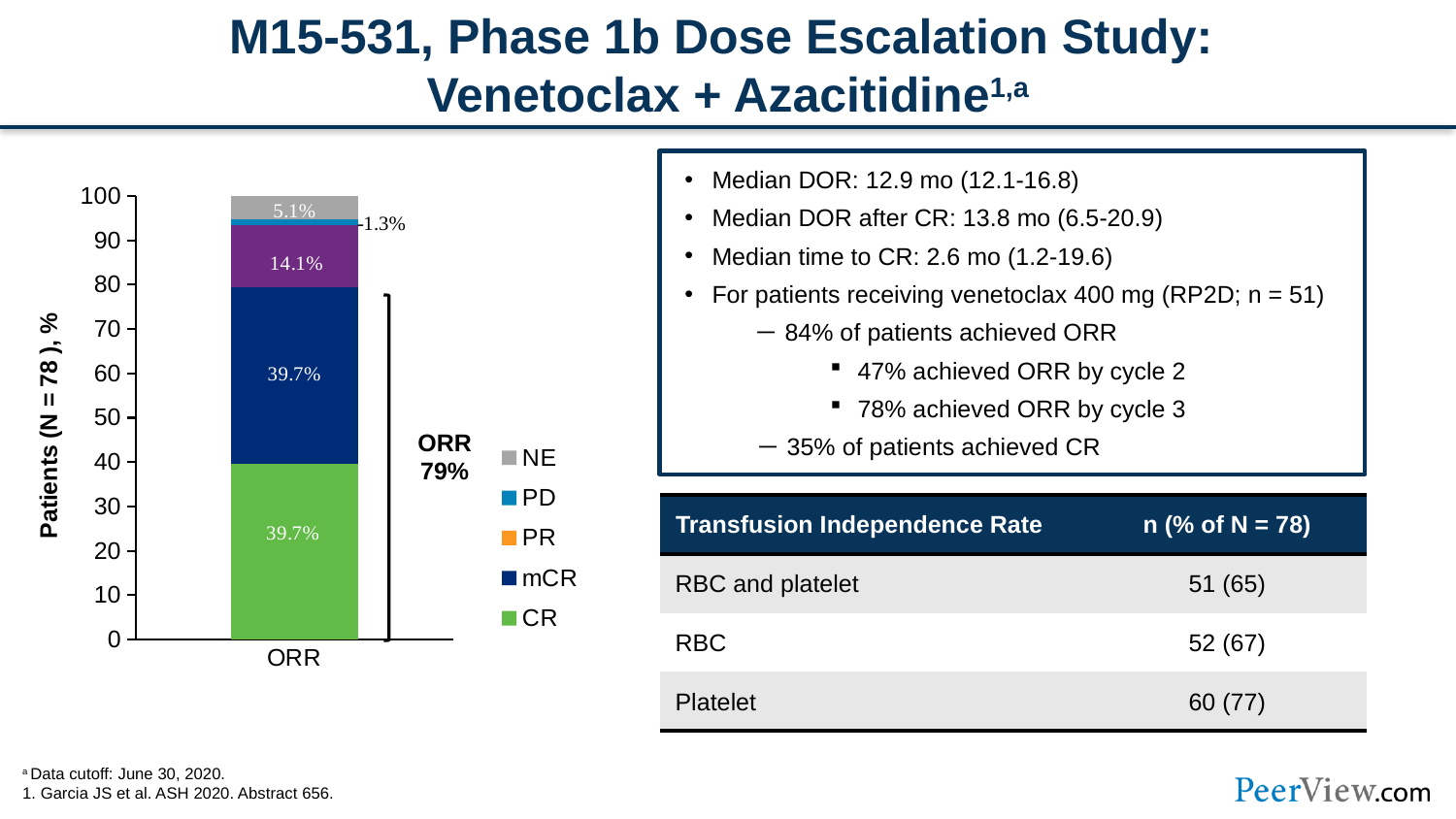
What is the value labeled for PD in the ORR bar? 1.3% What is the difference between the NE and PD values in the ORR bar? 3.8% What kind of chart is shown on the slide? Stacked bar chart Which is larger in the ORR bar, NE or PD? NE How many series does the chart legend list? 5 What is the value labeled for mCR in the ORR bar? 39.7% What is the value labeled for CR in the ORR bar? 39.7% How many bars are plotted in the chart? 1 What is the difference between the mCR and NE values in the ORR bar? 34.6% Which segment of the ORR bar has the smallest value? PD What ORR percentage is annotated next to the bar? 79% What is the value labeled for NE in the ORR bar? 5.1%